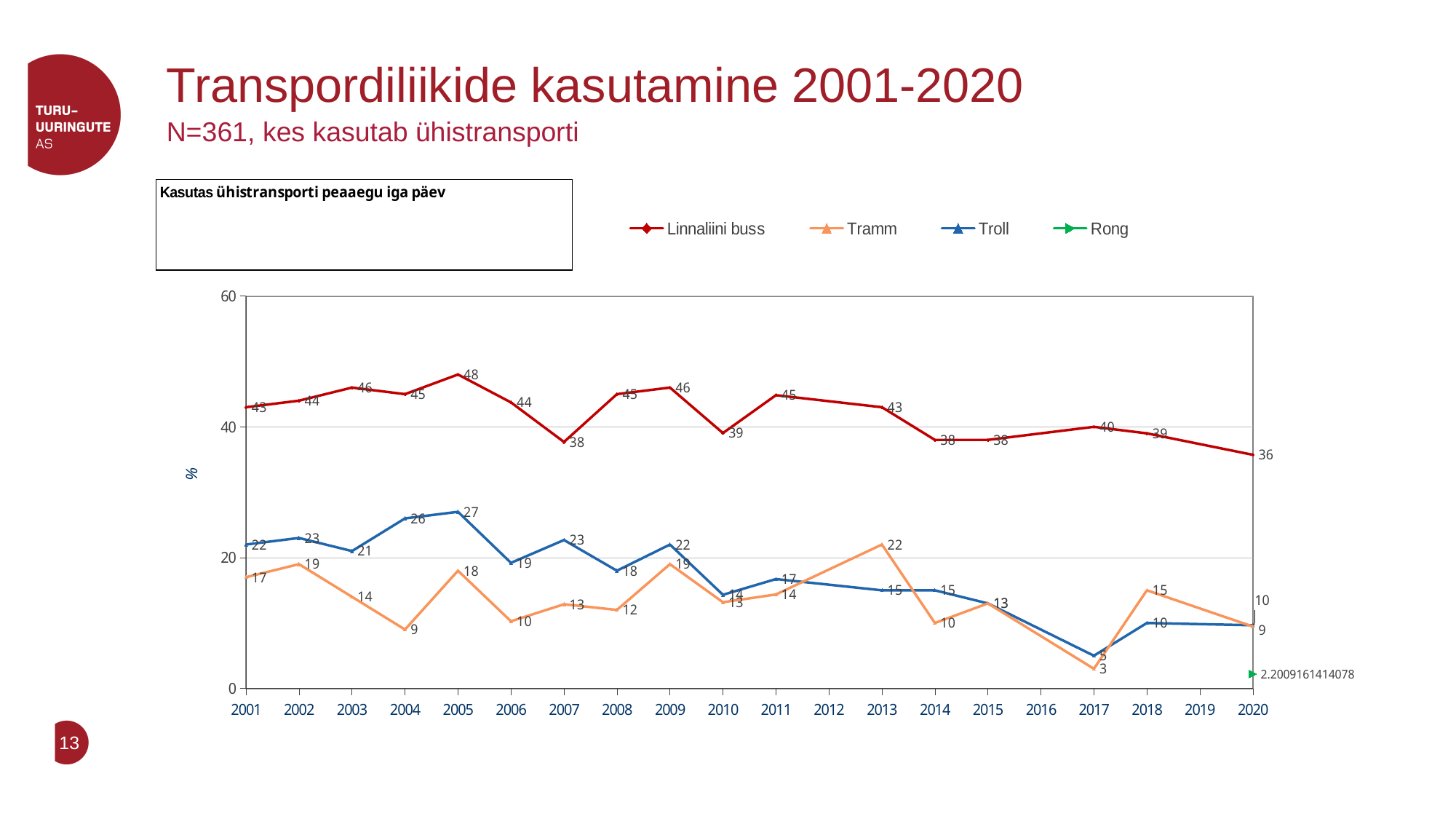
In which year does Linnaliini buss reach its highest value? 2005 In which year does Tramm have its lowest value? 2017 What is the value for Linnaliini buss in 2020? 36 In 2013, which is larger: Tramm or Troll? Tramm What is the value for Linnaliini buss in 2005? 48 What kind of chart is shown on the slide? line chart Is the value for Linnaliini buss in 2007 greater or less than 40? less What is the difference between the Linnaliini buss values in 2001 and 2020? 7 What is the value for Troll in 2005? 27 What is the label on the vertical axis? % What is the value for Tramm in 2017? 3 How many series does the legend list? 4